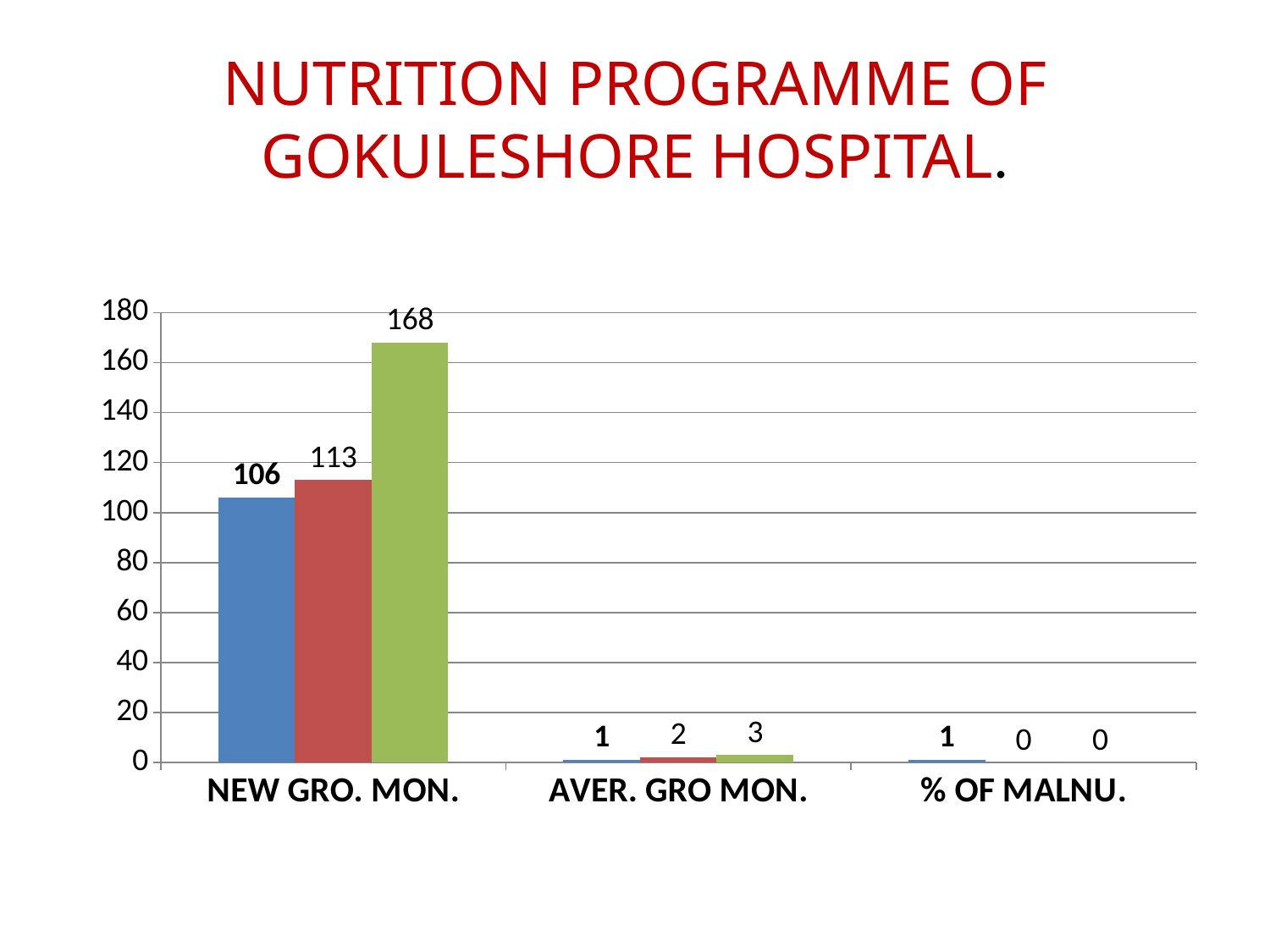
Is the value of the green bar for NEW GRO. MON. greater or less than 160? greater What is the value of the blue bar for NEW GRO. MON.? 106 How many categories are shown on the x axis of the chart? 3 What is the difference between the red bar and the blue bar for NEW GRO. MON.? 7 What is the value of the red bar for NEW GRO. MON.? 113 What type of chart is shown on the slide? bar chart What is the value of the green bar for AVER. GRO MON.? 3 What is the value of the red bar for % OF MALNU.? 0 Which category has the highest values in the chart? NEW GRO. MON. What is the value of the green bar for NEW GRO. MON.? 168 What is the difference between the green bar and the blue bar for NEW GRO. MON.? 62 Which is larger for NEW GRO. MON., the red bar or the green bar? the green bar